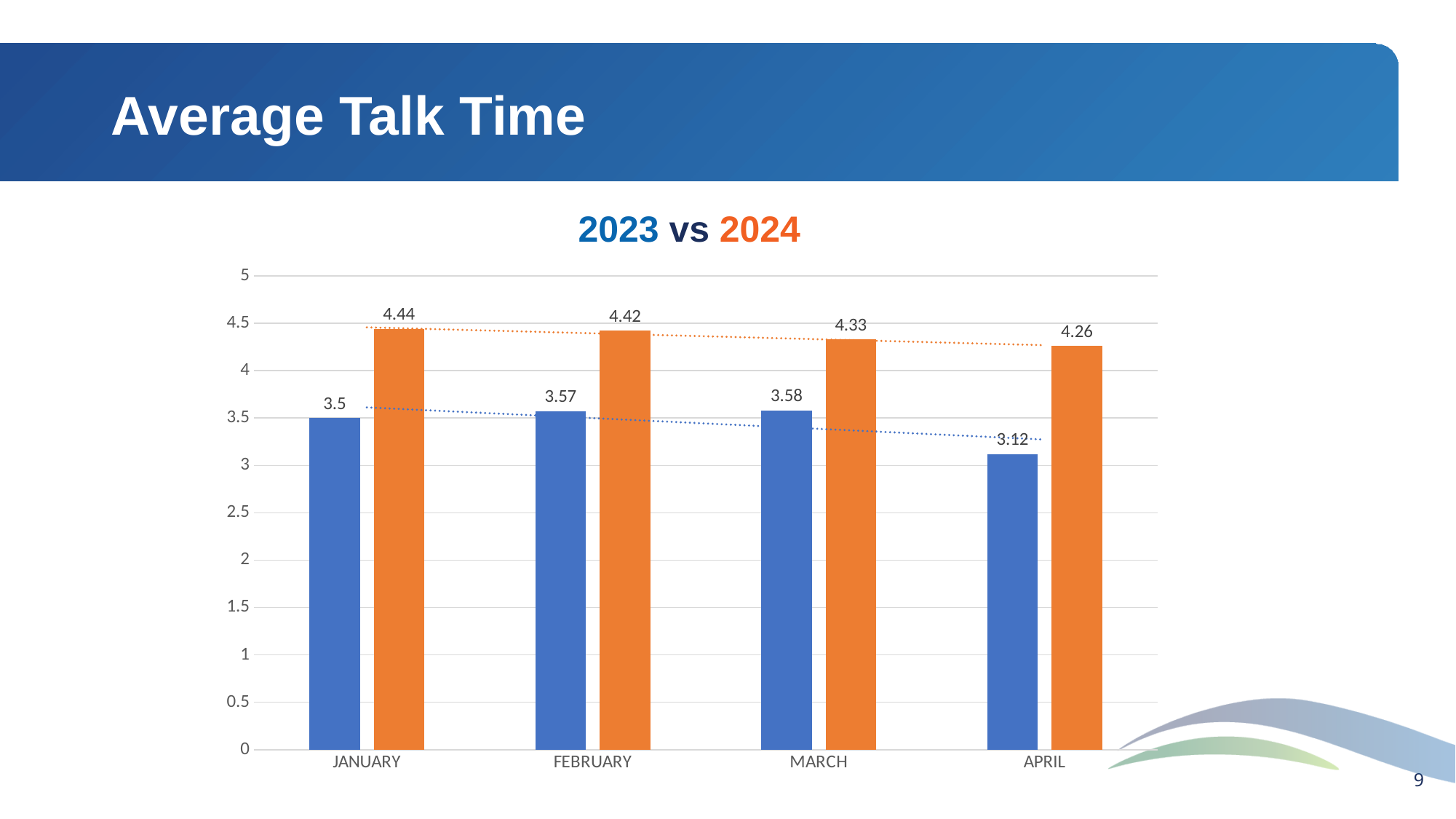
Which is larger, the 2023 value for March or the 2024 value for March? 2024 value for March Which month has the lowest 2024 value? April What is the 2023 value for February? 3.57 Do the 2024 values rise or fall from January to April? fall How many months are shown on the x axis? 4 What is the 2024 value for January? 4.44 Which month has the lowest 2023 value? April What type of chart is shown on the slide? bar chart What is the difference between the 2024 and 2023 values for April? 1.14 What is the 2024 value for March? 4.33 What is the difference between the 2024 and 2023 values for January? 0.94 What is the 2023 value for April? 3.12